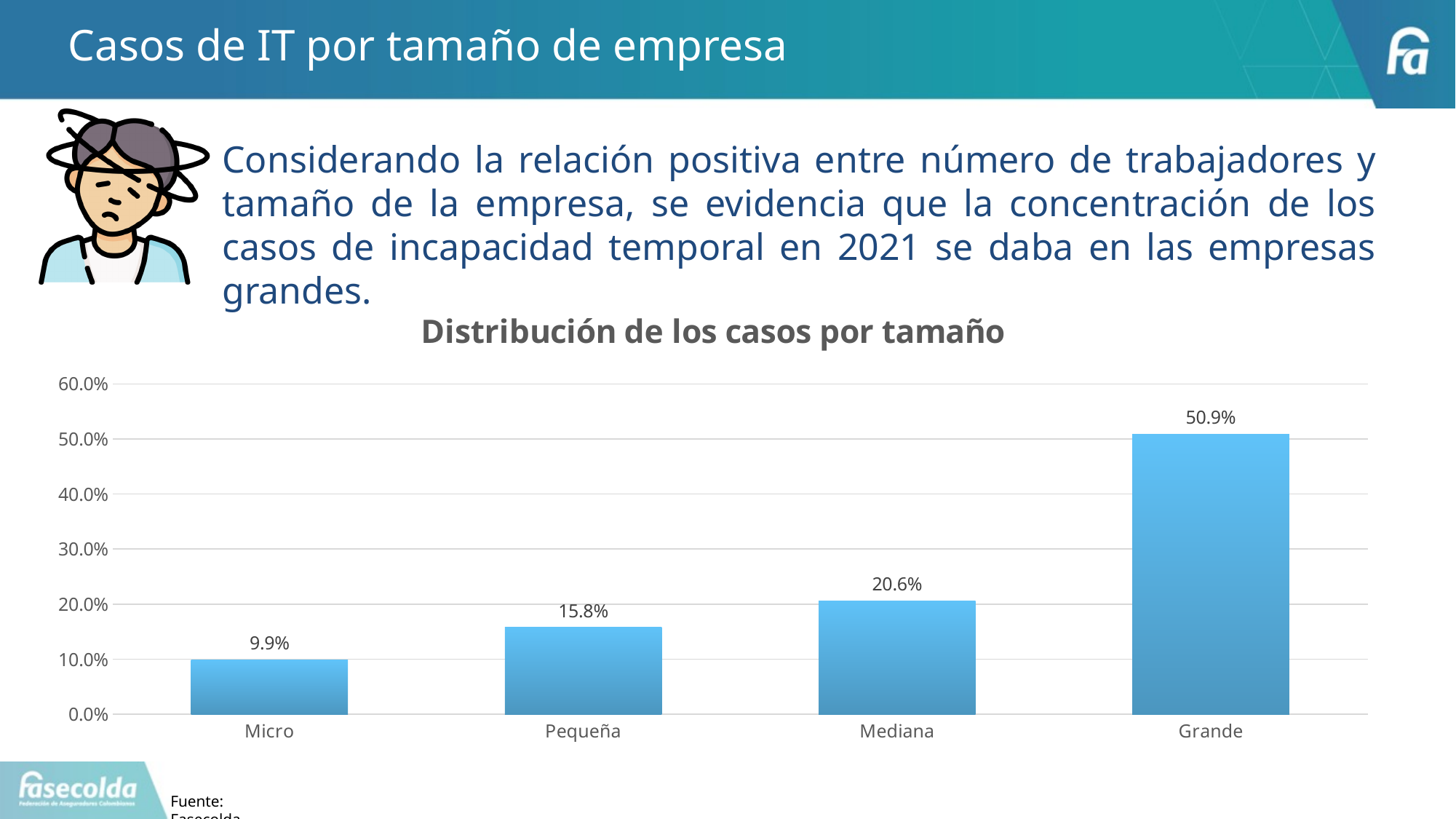
What is the value for Micro? 9.9% What is the value for Mediana? 20.6% How many categories are shown on the x axis? 4 What is the difference between the values for Grande and Mediana? 30.3% Which category has the highest value? Grande What is the value for Pequeña? 15.8% Is the value for Grande greater or less than 50.0%? greater Which is larger, the value for Pequeña or the value for Mediana? Mediana What is the title of the chart? Distribución de los casos por tamaño What kind of chart is shown on the slide? Bar chart What is the value for Grande? 50.9% Which category has the lowest value? Micro